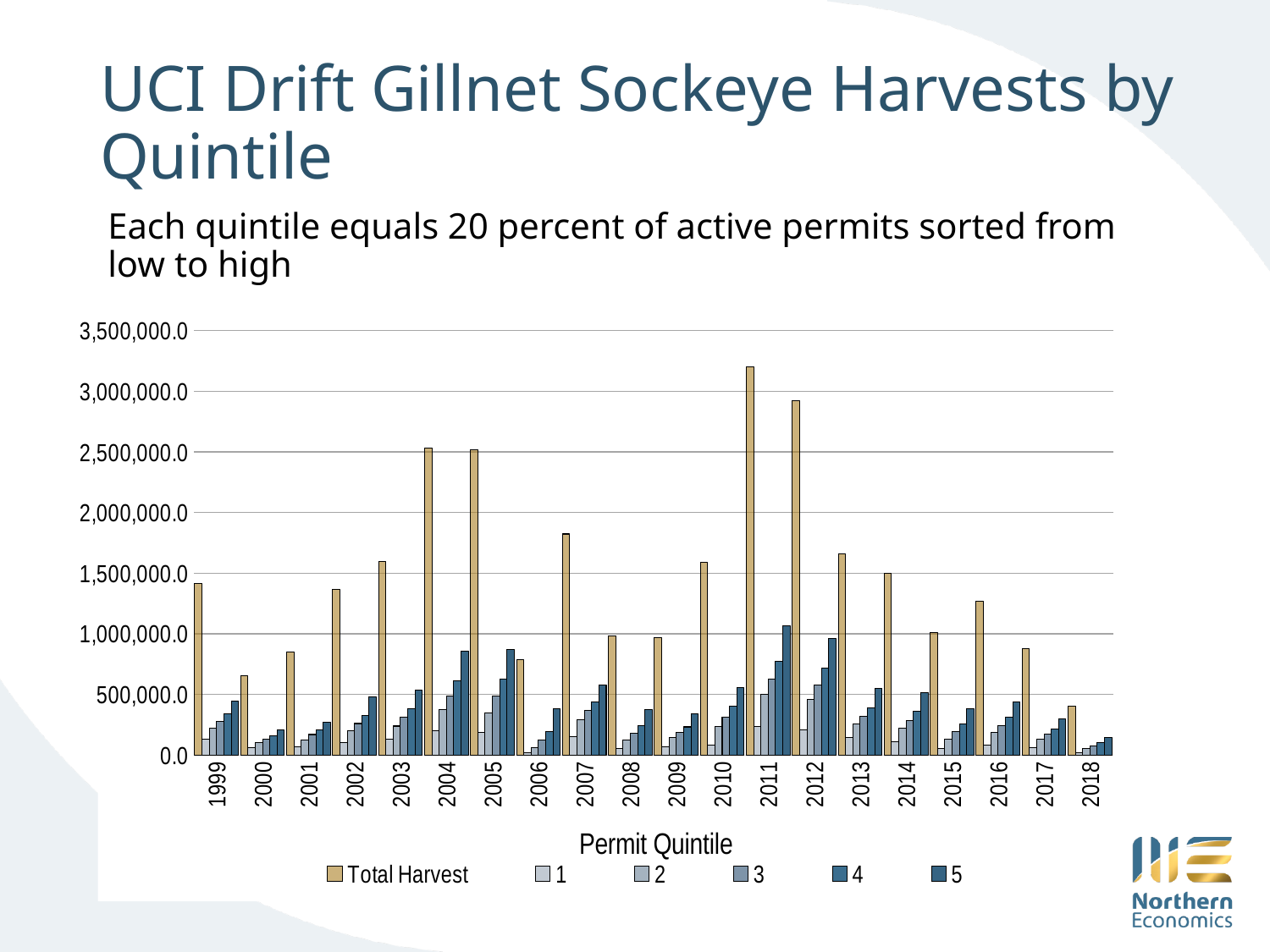
In which year is the Total Harvest bar lowest? 2018 What kind of chart is shown on the slide? bar chart Is the value for quintile 5 in 2004 greater or less than 500,000? greater How many years are shown along the x axis? 20 In which year is the Total Harvest bar highest? 2011 Is the Total Harvest value for 2018 greater or less than 500,000? less Is the Total Harvest value for 2006 greater or less than 500,000? greater What is the title shown above the legend entries? Permit Quintile How many series does the legend list? 6 Which year has the larger Total Harvest, 2001 or 2002? 2002 Does the Total Harvest rise or fall from 2011 to 2015? fall